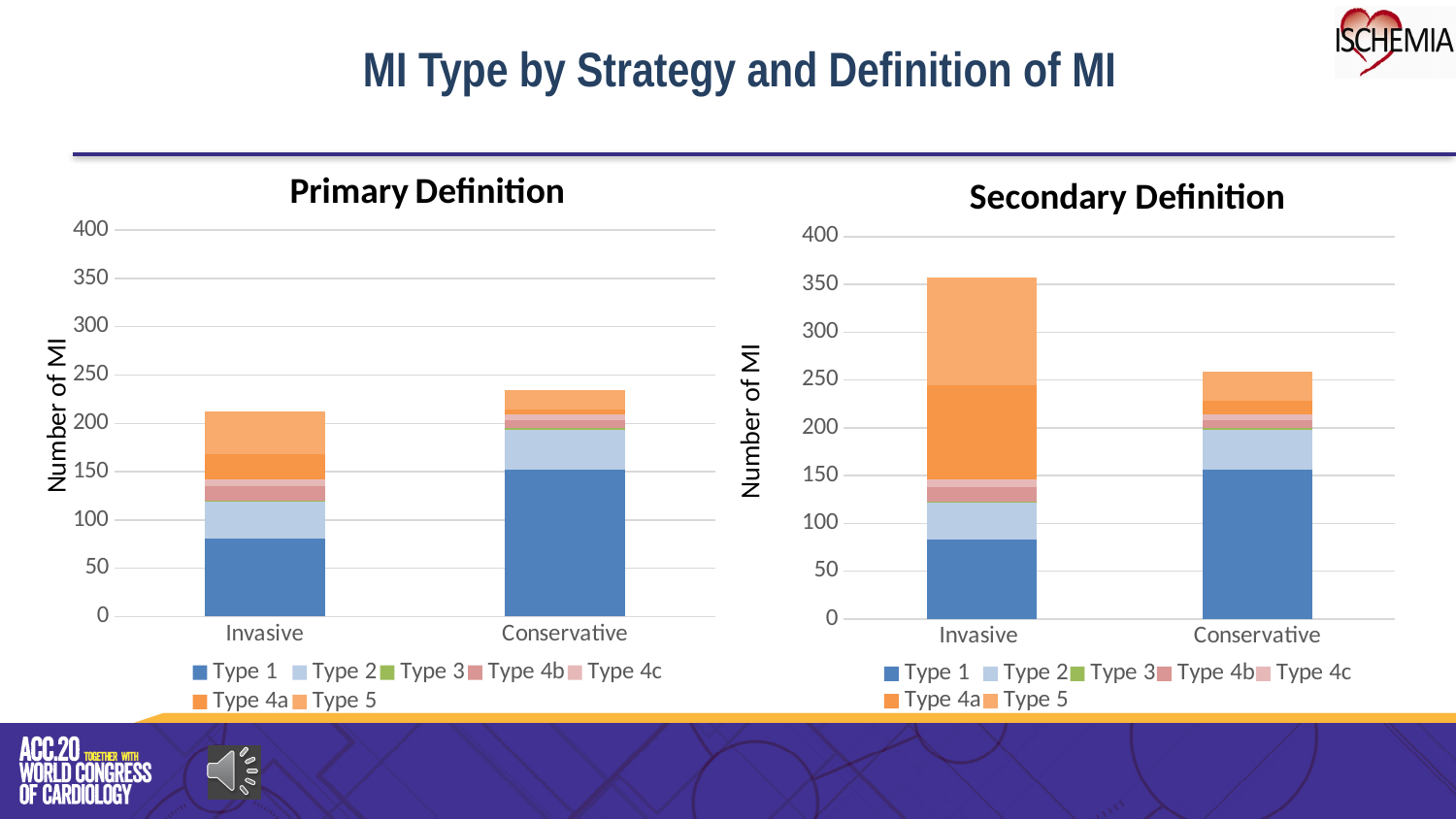
In the Primary Definition chart, is the total height of the Invasive bar greater or less than 250? less In the Secondary Definition chart, which category has the taller stacked bar, Invasive or Conservative? Invasive How many categories are shown on the x axis of the Primary Definition chart? 2 How many series does the legend of the Secondary Definition chart list? 7 In the Secondary Definition chart, is the total height of the Conservative bar greater or less than 300? less What is the title of the chart on the left side of the slide? Primary Definition In the Primary Definition chart, is the Type 1 segment larger for Invasive or for Conservative? Conservative What kind of chart is the Primary Definition chart? stacked bar chart In the Primary Definition chart, which category has the taller stacked bar, Invasive or Conservative? Conservative In the Secondary Definition chart, is the total height of the Invasive bar greater or less than 300? greater What is the y-axis label on the Secondary Definition chart? Number of MI